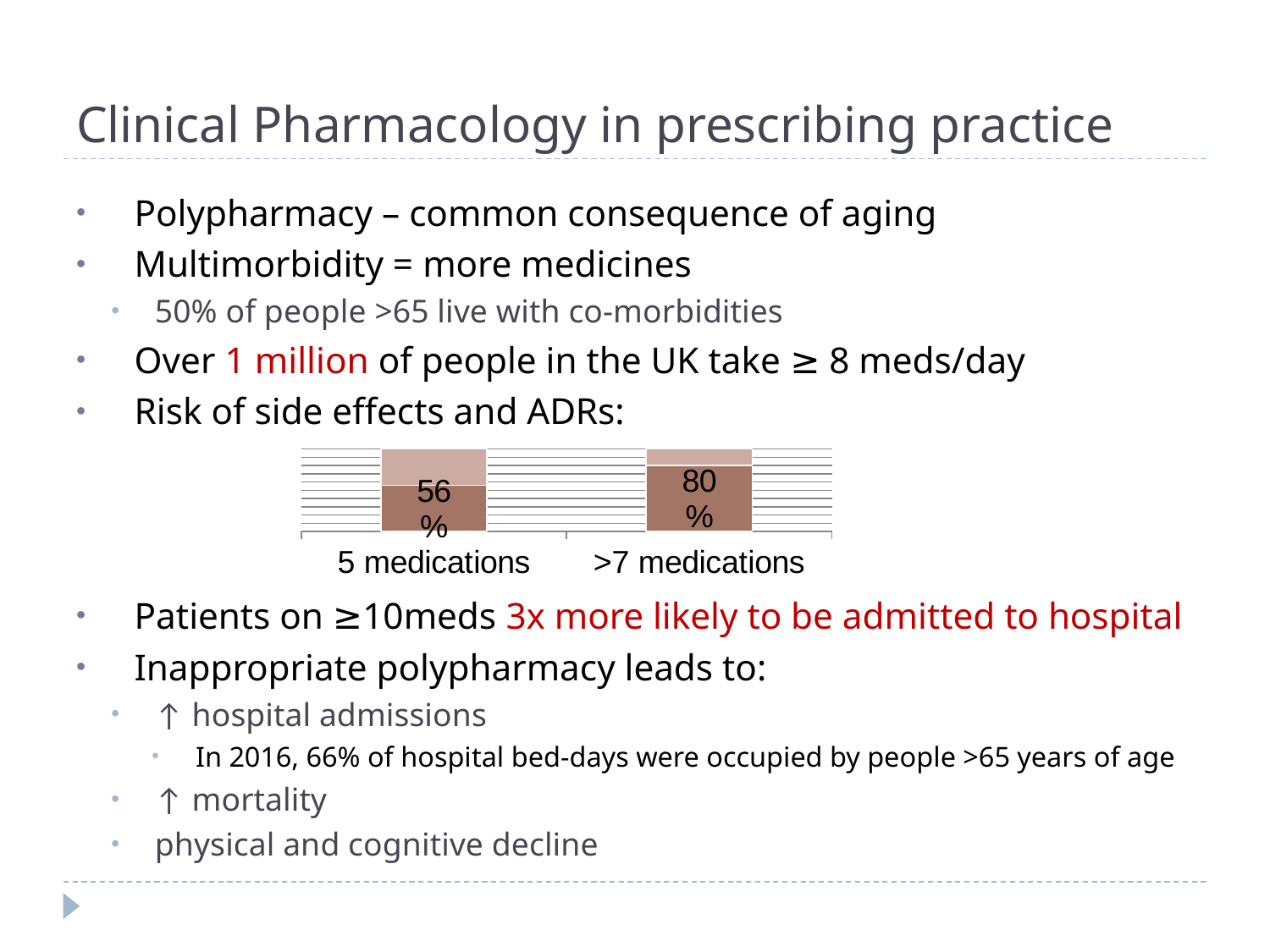
What are the two category labels on the x axis of the chart? 5 medications and >7 medications What kind of chart is shown on the slide? bar chart What is the difference between the values for >7 medications and 5 medications? 24 percentage points Is the value for >7 medications larger or smaller than the value for 5 medications? larger Do the labelled values rise or fall from 5 medications to >7 medications? rise Which category has the higher value? >7 medications What is the value shown for >7 medications? 80% What is the value shown for 5 medications? 56% Which category has the lower value? 5 medications How many categories are shown on the x axis of the chart? 2